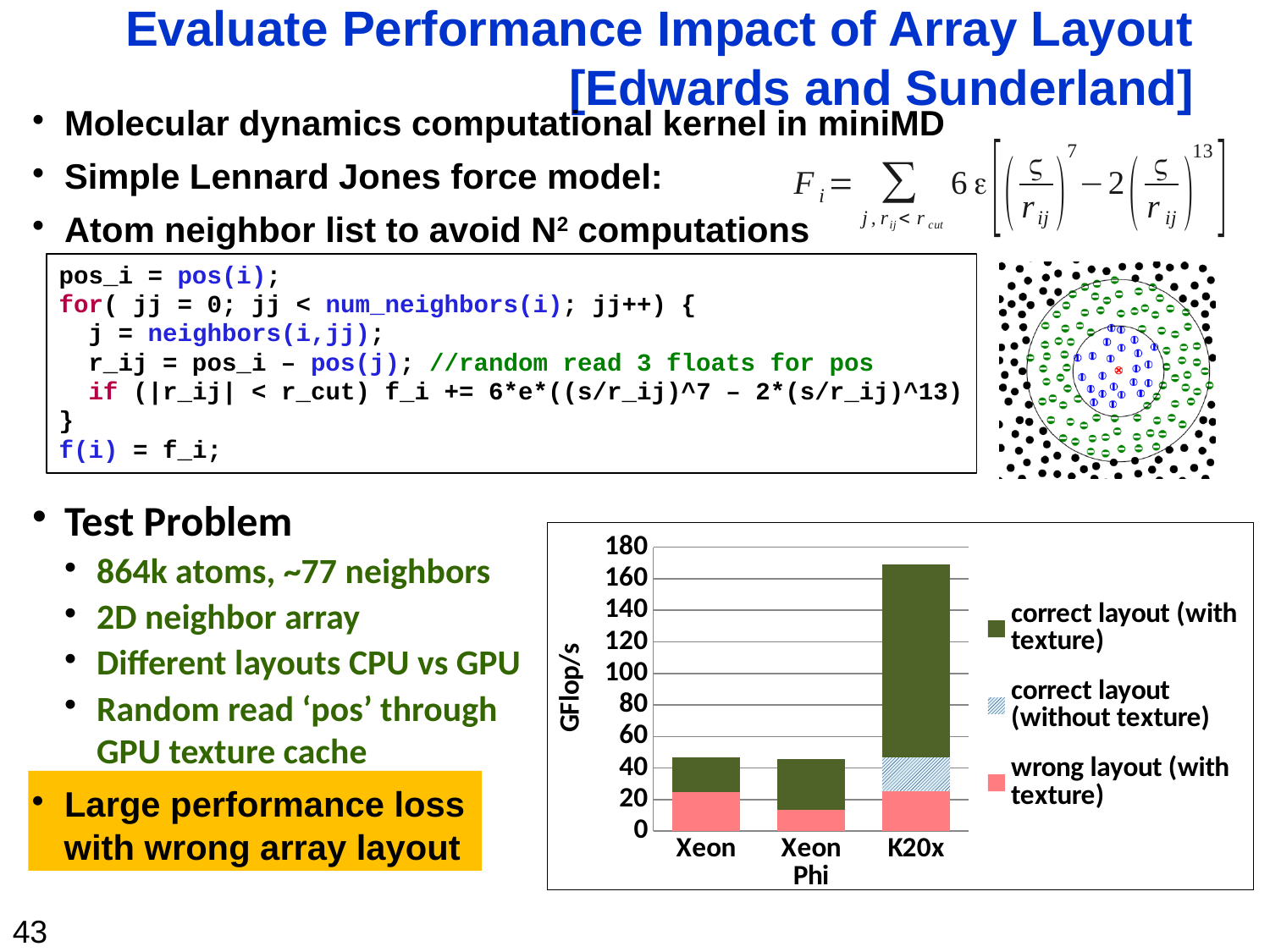
Which category is the only one with a visible 'correct layout (without texture)' segment? K20x Which has the larger total stacked bar, Xeon or K20x? K20x Which category has the smallest 'wrong layout (with texture)' value? Xeon Phi How many categories are shown on the x axis of the chart? 3 Is the total stacked bar for Xeon greater or less than 60? less Is the total stacked bar for K20x greater or less than 140? greater How many series does the chart's legend list? 3 What kind of chart is shown on the slide? bar chart What is the label on the y axis of the chart? GFlop/s Which category has the tallest stacked bar in the chart? K20x Is the 'wrong layout (with texture)' value for Xeon Phi greater or less than 20? less